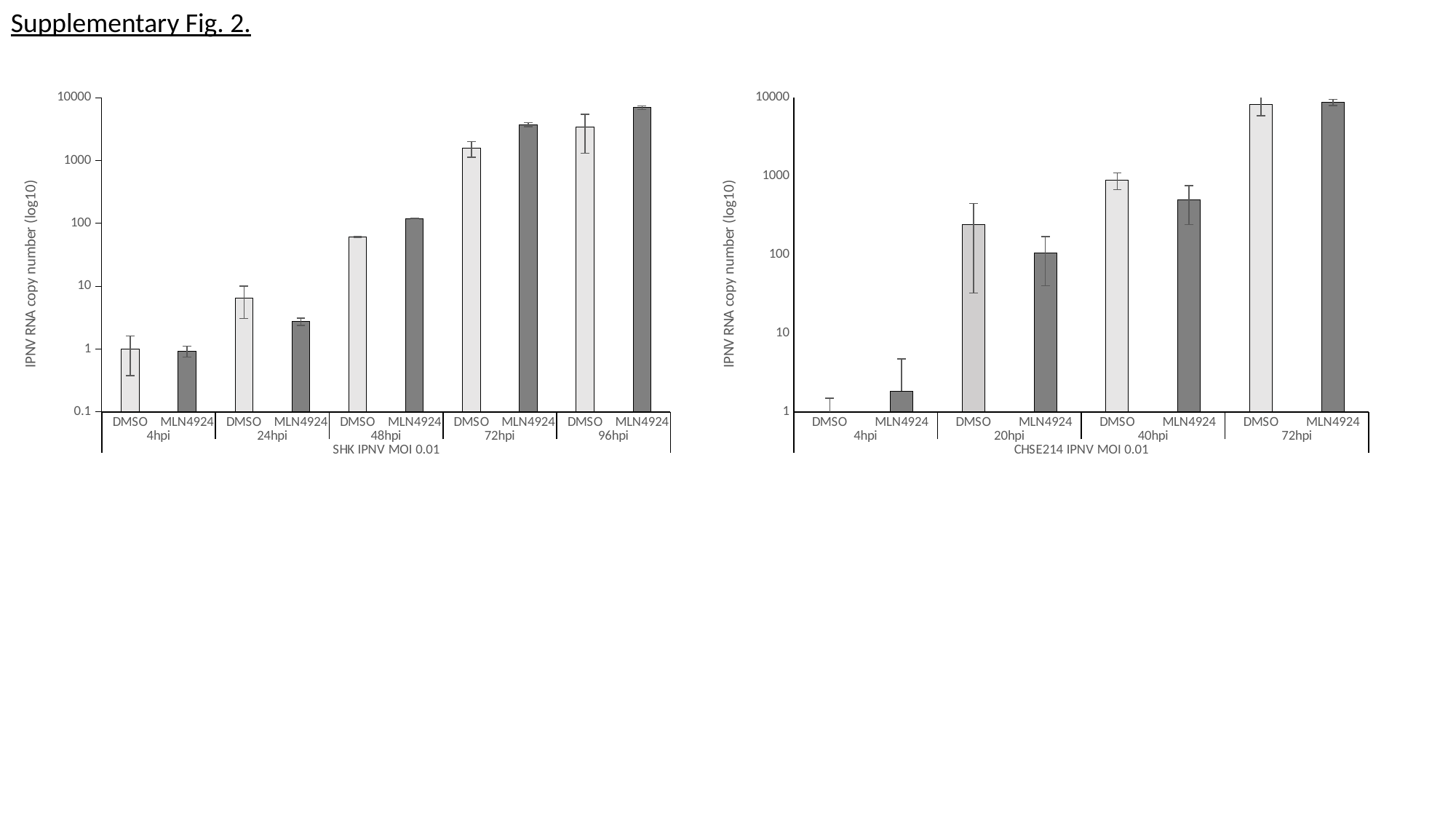
In the right chart (CHSE214 IPNV MOI 0.01), is the value for MLN4924 at 40hpi greater or less than 1000? less In the left chart (SHK IPNV MOI 0.01), is the value for DMSO at 48hpi greater or less than 100? less In the left chart (SHK IPNV MOI 0.01), how many time points are shown along the x axis? 5 In the left chart (SHK IPNV MOI 0.01), which bar is the highest? MLN4924 at 96hpi In the right chart (CHSE214 IPNV MOI 0.01), at 40hpi, which is larger: DMSO or MLN4924? DMSO In the left chart (SHK IPNV MOI 0.01), do the DMSO values rise or fall from 4hpi to 96hpi? rise In the left chart (SHK IPNV MOI 0.01), at 48hpi, which is larger: DMSO or MLN4924? MLN4924 What kind of chart is the left chart titled SHK IPNV MOI 0.01? bar chart What is the y-axis title of the right chart (CHSE214 IPNV MOI 0.01)? IPNV RNA copy number (log10) In the right chart (CHSE214 IPNV MOI 0.01), is the value for DMSO at 20hpi greater or less than 100? greater